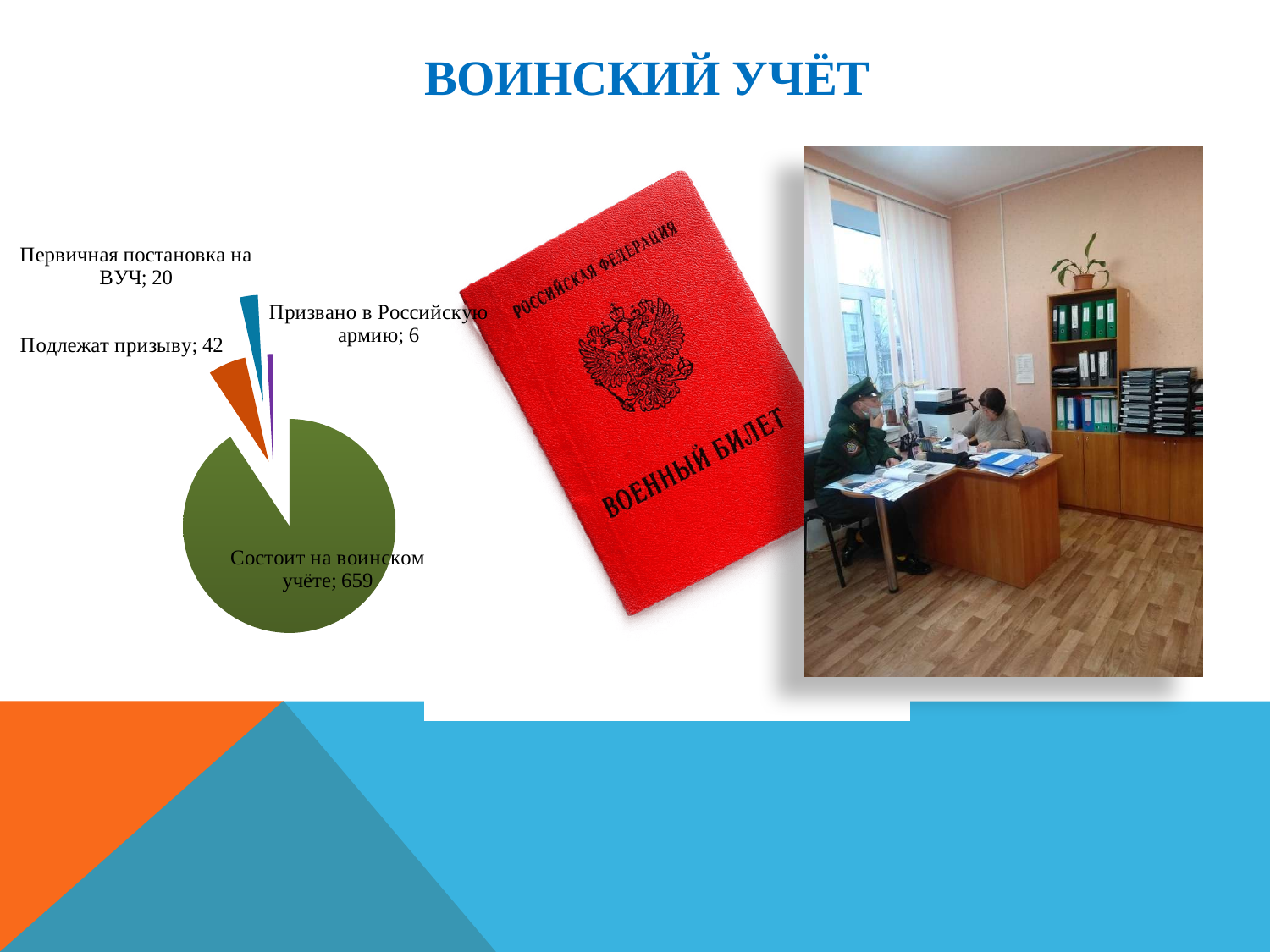
What is the total of all four values in the pie chart? 727 Which category has the smallest slice of the pie? Призвано в Российскую армию What kind of chart is shown on the slide? pie chart What is the title of the slide containing the pie chart? ВОИНСКИЙ УЧЁТ What is the value for "Состоит на воинском учёте"? 659 What is the value for "Первичная постановка на ВУЧ"? 20 Which is larger: "Подлежат призыву" or "Призвано в Российскую армию"? Подлежат призыву What is the difference between "Подлежат призыву" and "Первичная постановка на ВУЧ"? 22 How many slices does the pie chart have? 4 What is the value for "Подлежат призыву"? 42 Which category has the largest slice of the pie? Состоит на воинском учёте What is the value for "Призвано в Российскую армию"? 6